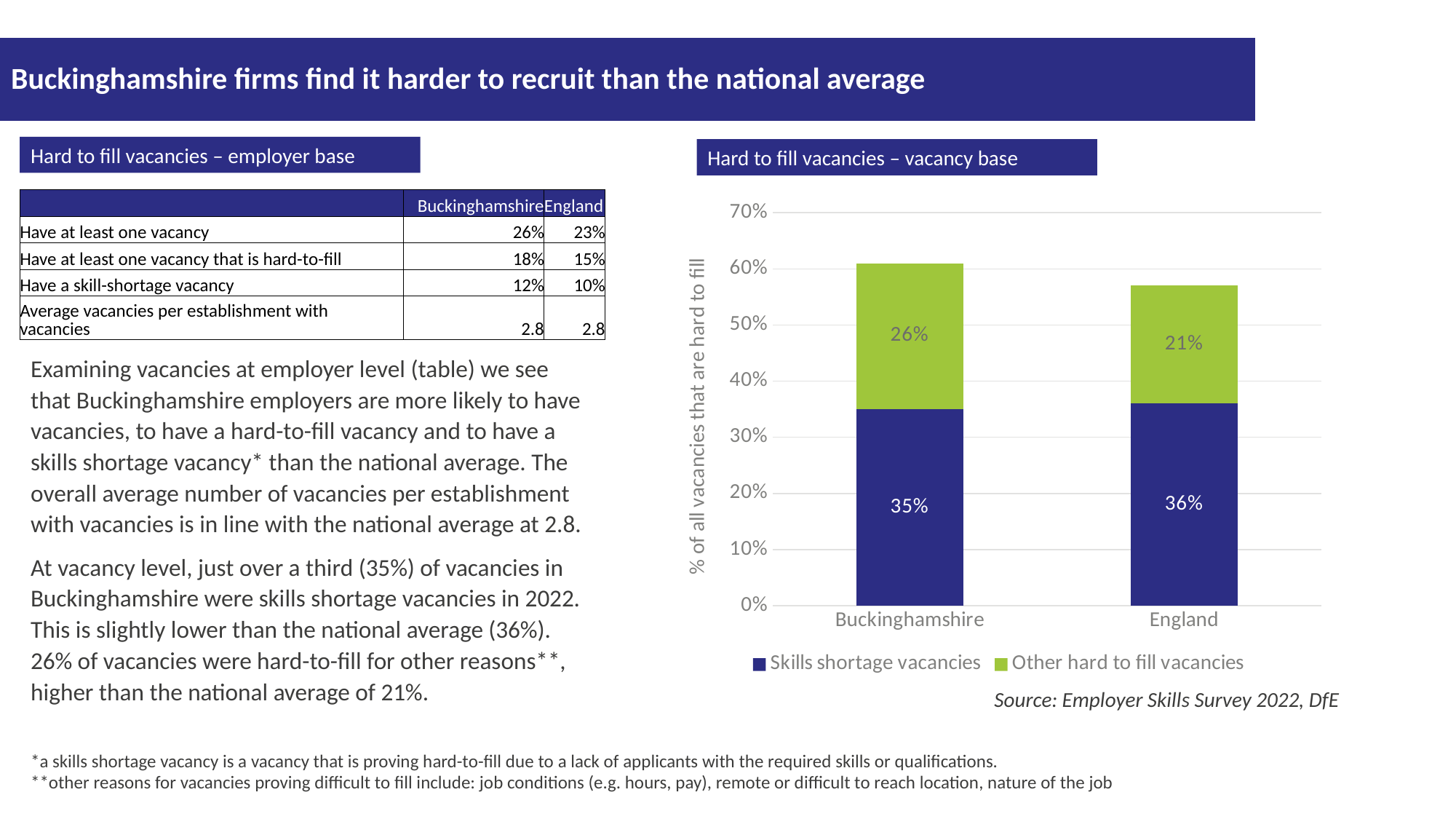
What is the value for Other hard to fill vacancies in Buckinghamshire? 26% What is the total of the stacked bar for England? 57% What kind of chart is shown on the slide? Stacked bar chart What is the difference between Other hard to fill vacancies in Buckinghamshire and in England? 5% What is the total of the stacked bar for Buckinghamshire? 61% What is the value for Skills shortage vacancies in England? 36% Which category has the higher value for Other hard to fill vacancies, Buckinghamshire or England? Buckinghamshire How many series does the chart legend list? 2 What is the title of the chart? Hard to fill vacancies – vacancy base What is the value for Other hard to fill vacancies in England? 21% What is the value for Skills shortage vacancies in Buckinghamshire? 35% How many categories are shown on the x axis of the chart? 2